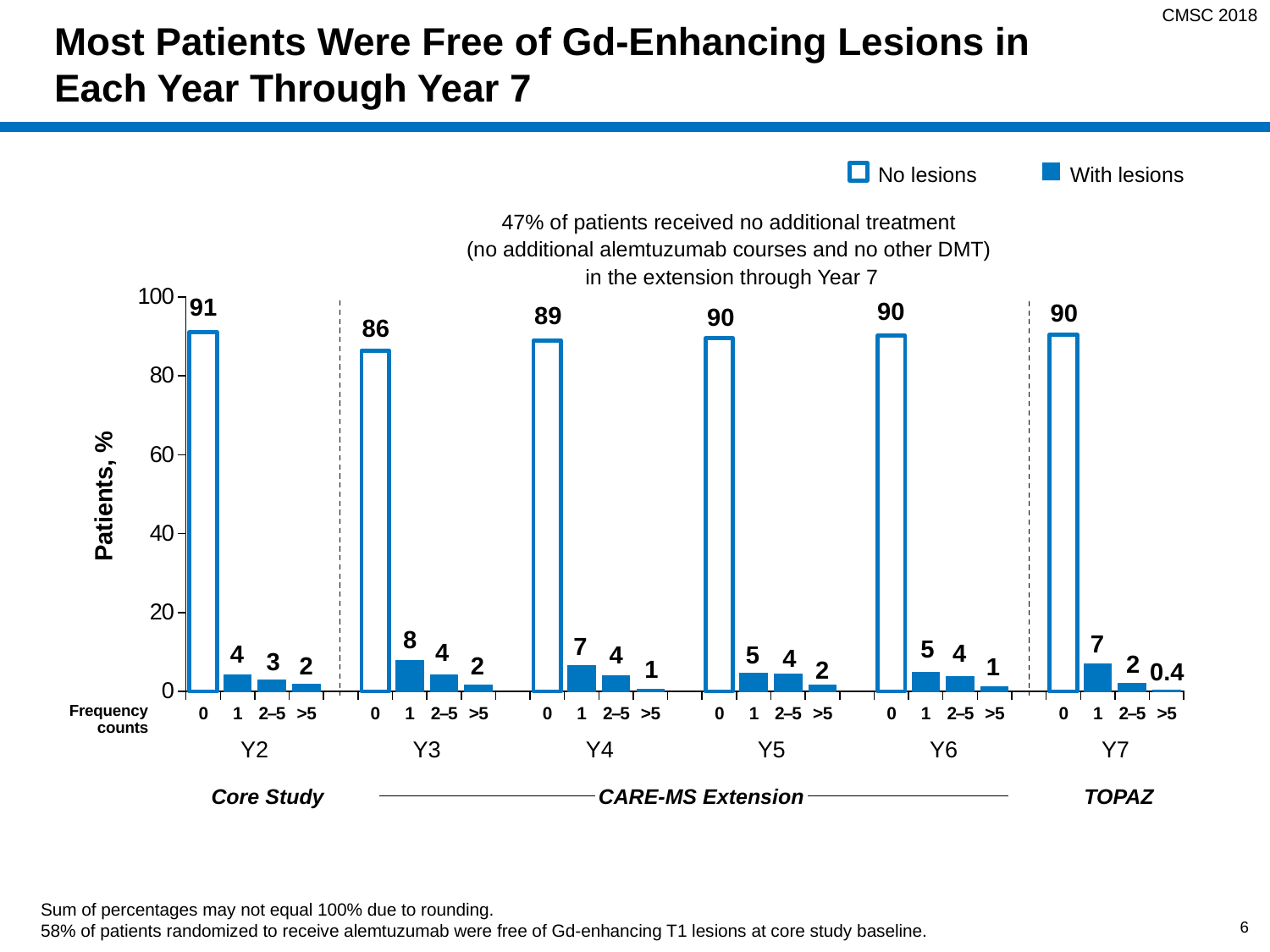
What is the difference between the percentage of patients with no lesions in Y2 and in Y3? 5 What kind of chart is shown on the slide? Bar chart Which study period does Y7 belong to, according to the label below the x axis? TOPAZ What percentage of patients had a frequency count of 1 lesion in Y4? 7 How many series does the legend list? 2 What percentage of patients had >5 lesions in Y7? 0.4 What percentage of patients had no lesions (frequency count 0) in Y2? 91 What percentage of patients had 2–5 lesions in Y3? 4 Which year has the lowest percentage of patients with no lesions (frequency count 0)? Y3 Which year has the highest percentage of patients with no lesions (frequency count 0)? Y2 Is the percentage of patients with 1 lesion larger in Y3 or in Y5? Y3 How many years (Y2 through Y7) are shown along the x axis? 6